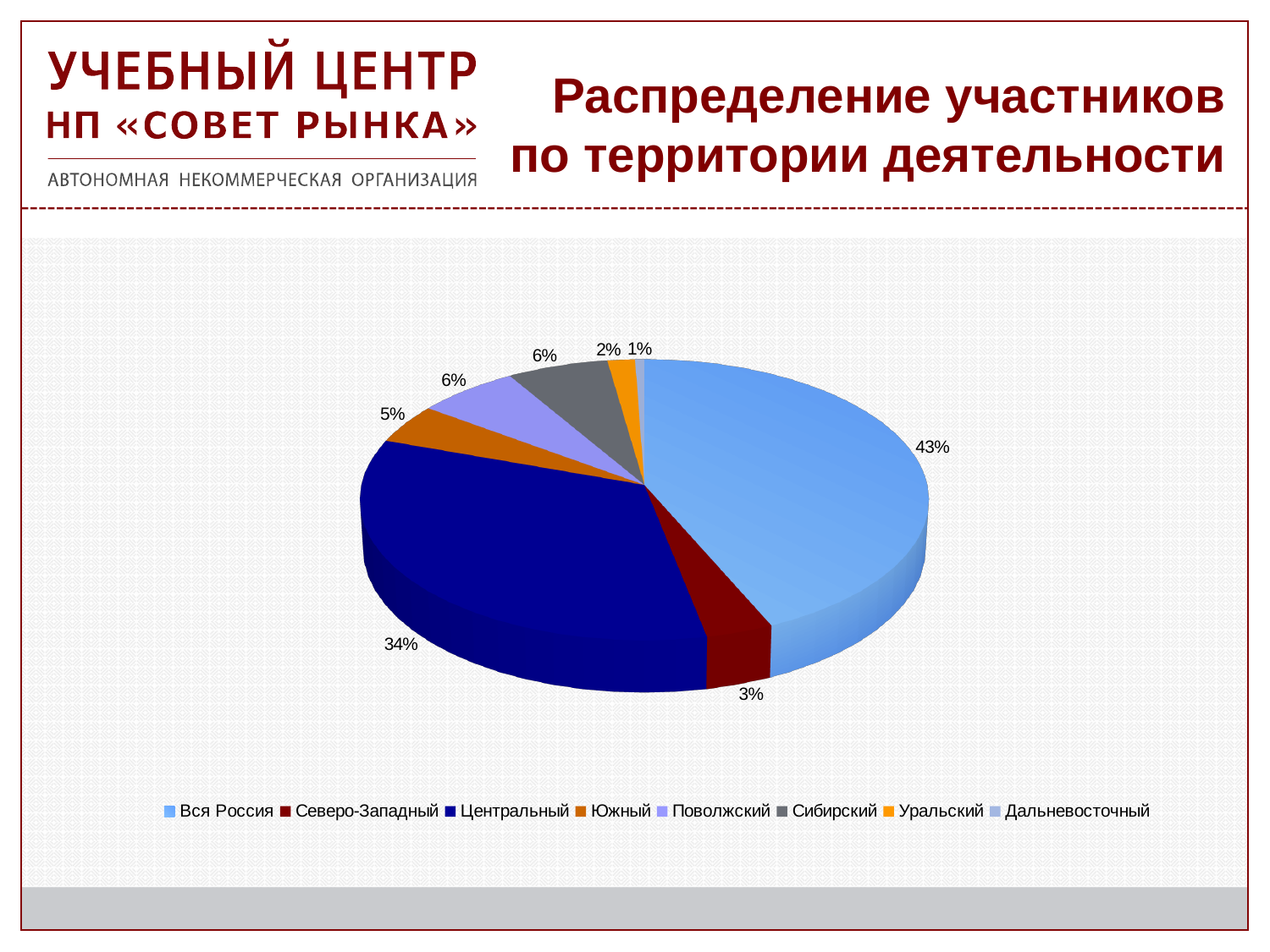
What kind of chart is shown on the slide? pie chart What share of participants does the Северо-Западный slice represent? 3% What share of participants does the Вся Россия slice represent? 43% What is the title of the chart on the slide? Распределение участников по территории деятельности What share of participants does the Южный slice represent? 5% Which category has the smallest share of the pie? Дальневосточный What share of participants does the Уральский slice represent? 2% Which category has the largest share of the pie? Вся Россия How many categories does the legend list? 8 What is the difference in percentage points between the Вся Россия and Центральный slices? 9 What share of participants does the Центральный slice represent? 34% Which is larger, the Южный slice or the Поволжский slice? Поволжский